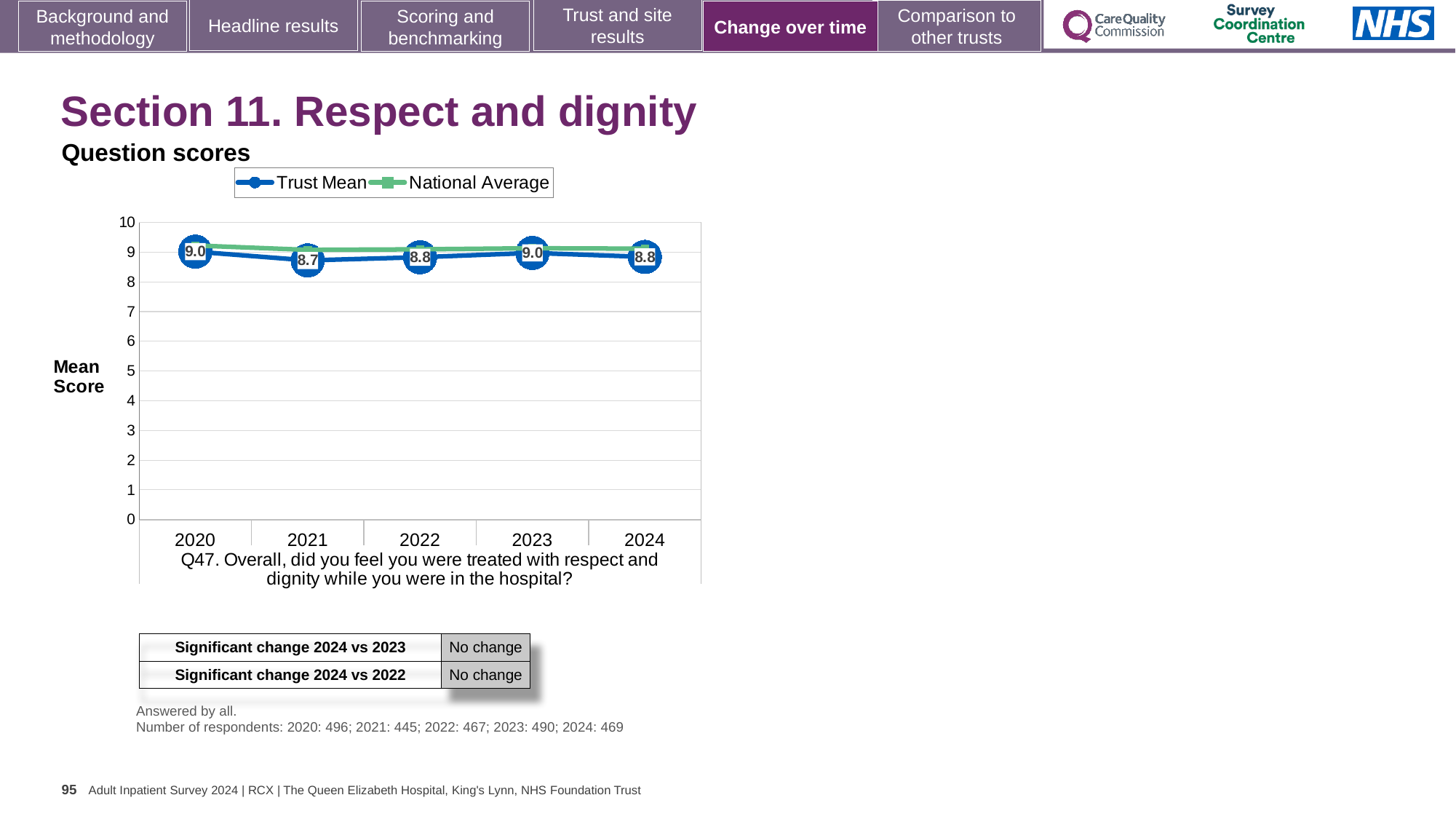
What is the Trust Mean score for 2020? 9.0 Is the National Average value for 2024 greater or less than 5? greater Which year has the larger Trust Mean score, 2021 or 2023? 2023 What kind of chart is shown on the slide? line chart Does the Trust Mean score rise or fall from 2020 to 2021? fall In which year is the Trust Mean score lowest? 2021 What is the difference between the Trust Mean scores for 2023 and 2021? 0.3 How many years are shown on the x axis of the chart? 5 What is the label on the y axis of the chart? Mean Score How many series does the chart legend list? 2 What is the Trust Mean score for 2024? 8.8 What is the Trust Mean score for 2021? 8.7